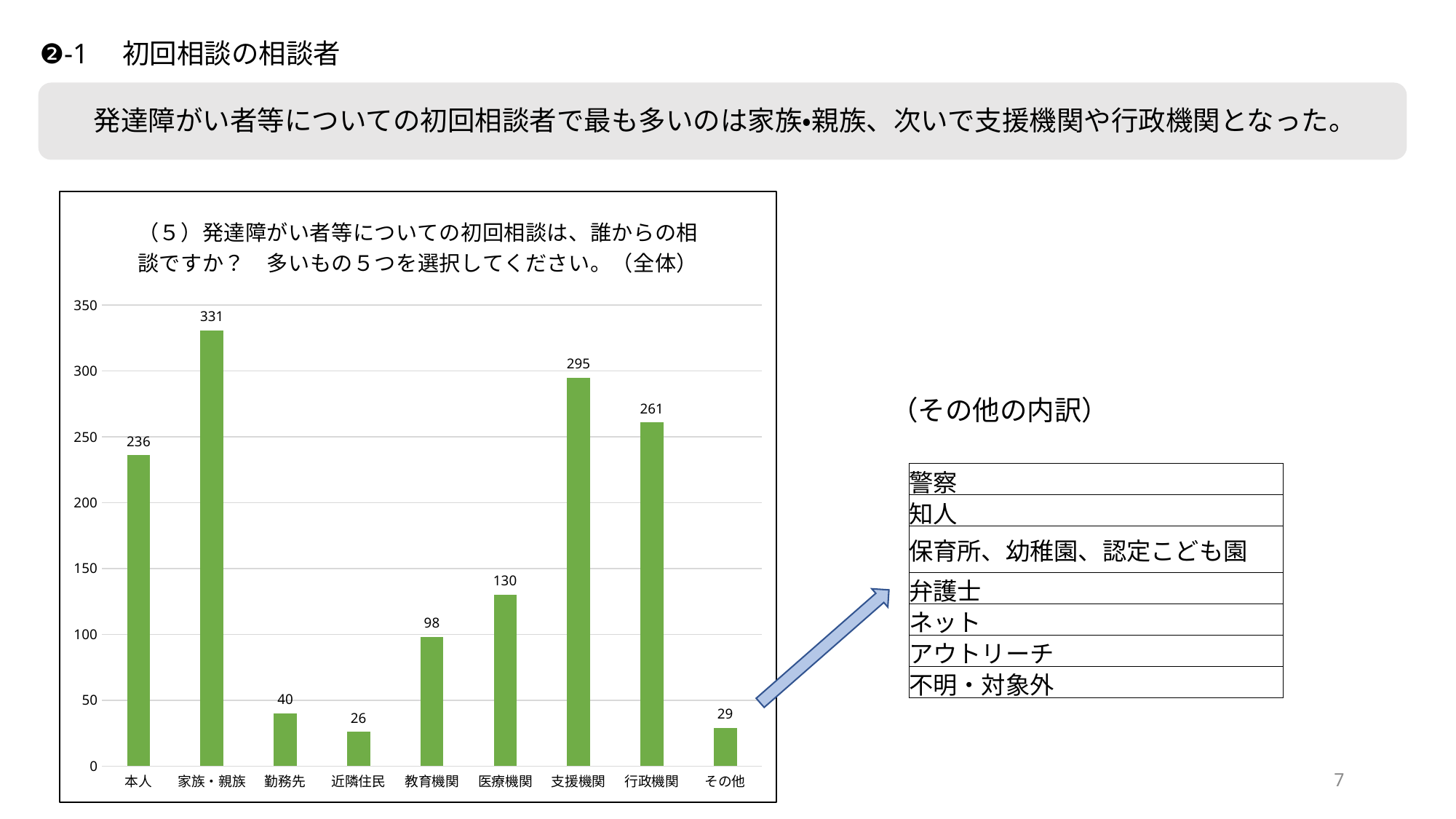
What kind of chart is shown on the slide? bar chart What is the value for 家族・親族? 331 What is the difference between the values for 家族・親族 and 支援機関? 36 What colour are the bars in the chart? green Which category has the highest value? 家族・親族 What is the value for 支援機関? 295 What is the difference between the values for 行政機関 and 本人? 25 Which is larger, the value for 医療機関 or the value for 教育機関? 医療機関 Which category has the lowest value? 近隣住民 Is the value for 本人 greater or less than 200? greater How many categories are shown on the x axis? 9 What is the value for 教育機関? 98